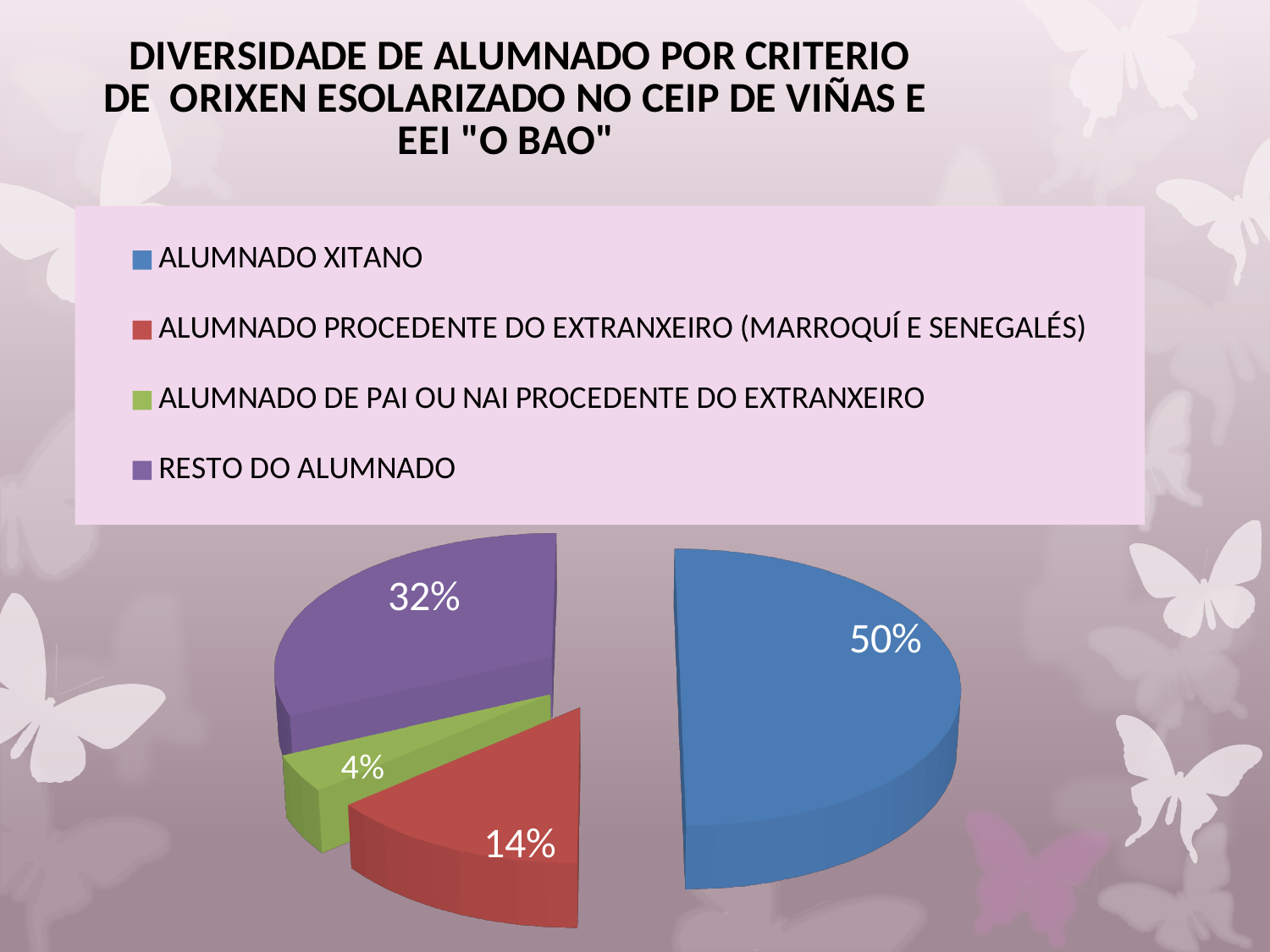
What kind of chart is shown on the slide? Pie chart Which is larger: the share for ALUMNADO PROCEDENTE DO EXTRANXEIRO (MARROQUÍ E SENEGALÉS) or the share for ALUMNADO DE PAI OU NAI PROCEDENTE DO EXTRANXEIRO? ALUMNADO PROCEDENTE DO EXTRANXEIRO (MARROQUÍ E SENEGALÉS) What colour is the slice for RESTO DO ALUMNADO? Purple What is the value shown for RESTO DO ALUMNADO? 32% How many categories does the pie chart show? 4 What is the difference between the share for ALUMNADO XITANO and the share for RESTO DO ALUMNADO? 18% What share of the pie does ALUMNADO XITANO represent? 50% What is the value shown for ALUMNADO PROCEDENTE DO EXTRANXEIRO (MARROQUÍ E SENEGALÉS)? 14% Which category has the largest slice of the pie? ALUMNADO XITANO Which category has the smallest slice of the pie? ALUMNADO DE PAI OU NAI PROCEDENTE DO EXTRANXEIRO What is the value shown for ALUMNADO DE PAI OU NAI PROCEDENTE DO EXTRANXEIRO? 4% Which legend entry is shown in blue? ALUMNADO XITANO